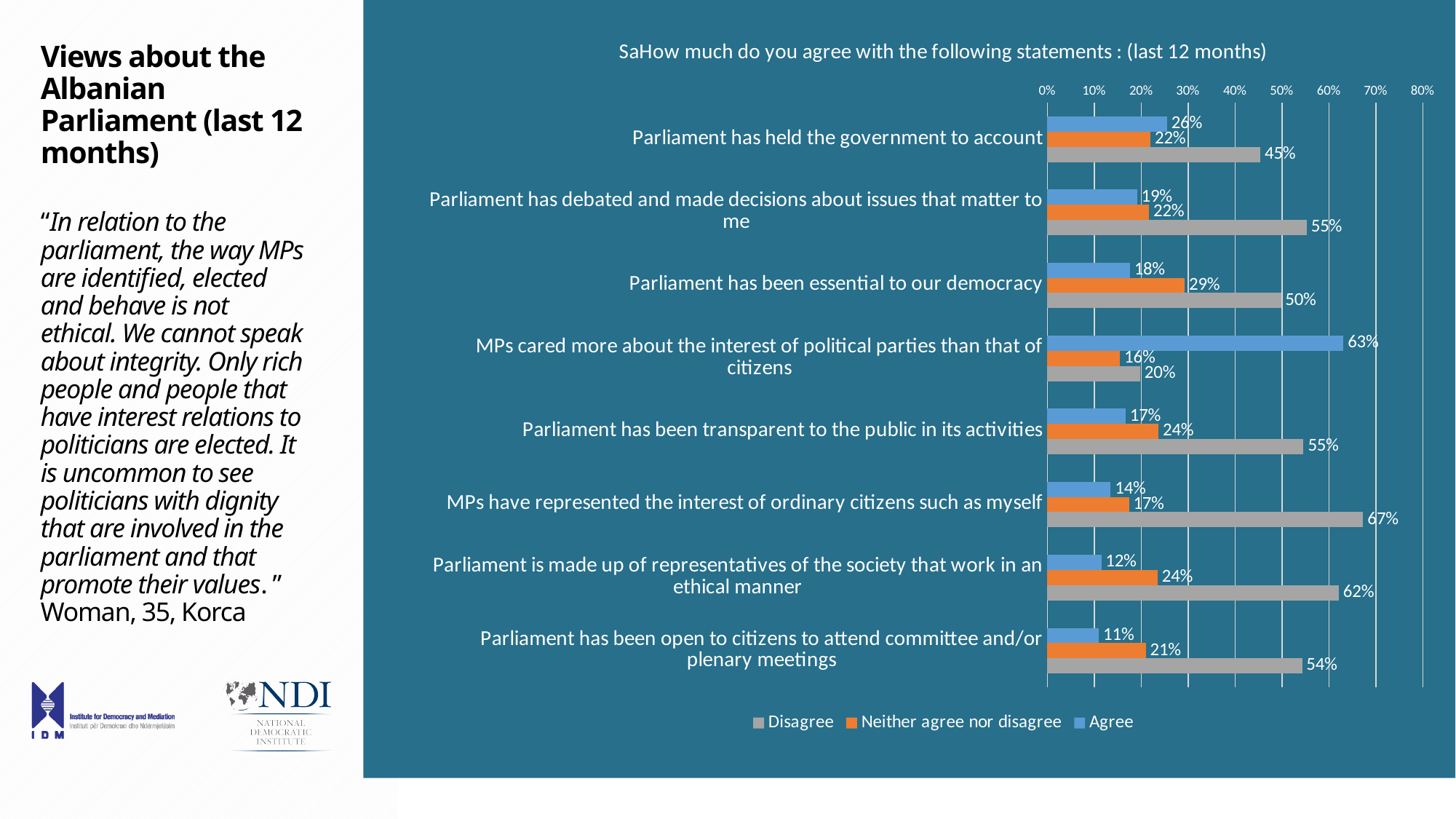
Which is larger for 'Parliament has been transparent to the public in its activities': the Disagree value or the Agree value? Disagree What is the Disagree percentage for 'Parliament is made up of representatives of the society that work in an ethical manner'? 62% Which statement has the lowest Agree percentage? Parliament has been open to citizens to attend committee and/or plenary meetings What percentage disagree that MPs have represented the interest of ordinary citizens such as myself? 67% What kind of chart is shown on the slide? Bar chart How many series does the legend list? 3 How many statements are listed on the chart? 8 Which series is shown in orange in the legend? Neither agree nor disagree What percentage agree that Parliament has held the government to account? 26% Which statement has the highest Agree percentage? MPs cared more about the interest of political parties than that of citizens What is the 'Neither agree nor disagree' value for 'Parliament has been essential to our democracy'? 29% What is the difference between the Disagree and Agree percentages for 'Parliament has held the government to account'? 19%